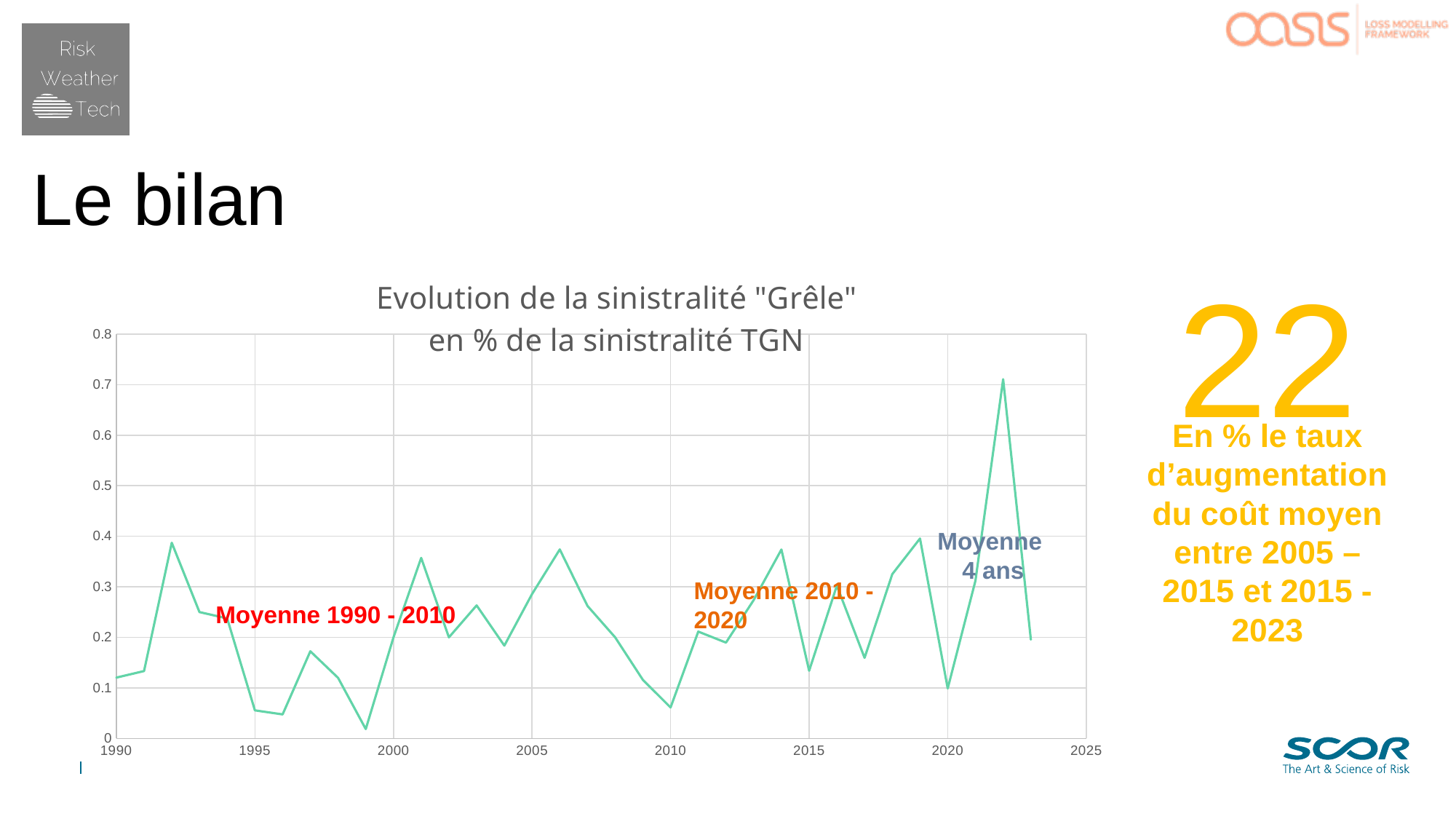
Which year has the larger value, 1999 or 2001? 2001 What kind of chart is shown on the slide? line chart What is the highest value shown on the vertical axis of the chart? 0.8 Which year has the larger value, 2022 or 1992? 2022 In which year does the line reach its highest value? 2022 In which year does the line reach its lowest value? 1999 Is the value for 2006 greater or less than 0.3? greater Is the value for 2010 greater or less than 0.1? less Is the value for 1992 greater or less than 0.3? greater What is the title of the chart? Evolution de la sinistralité "Grêle" en % de la sinistralité TGN